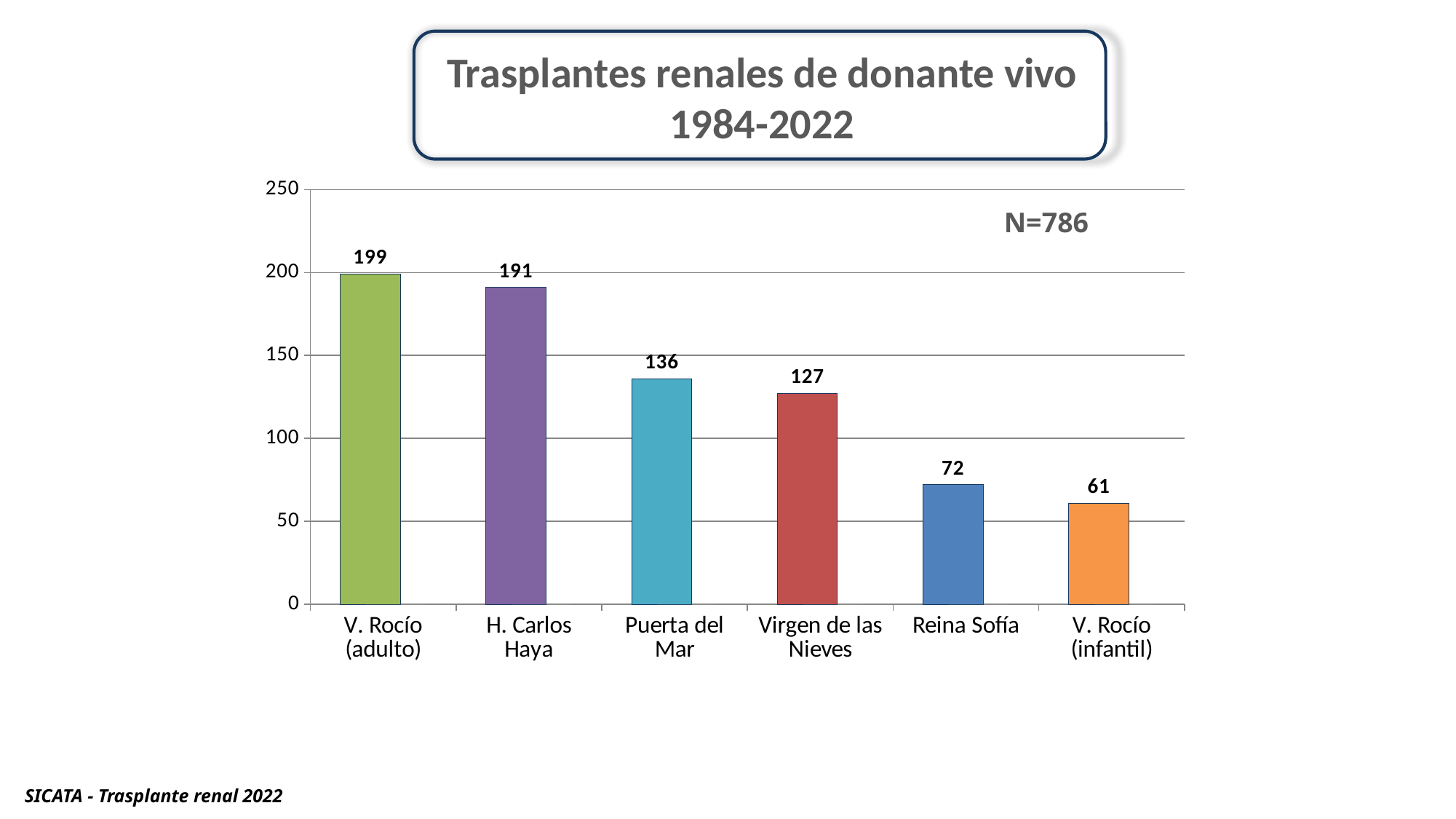
What kind of chart is shown on the slide? bar chart Is the value for Virgen de las Nieves greater or less than 150? less Do the values rise or fall from left to right along the x axis? fall Which is larger, the value for Puerta del Mar or the value for Reina Sofía? Puerta del Mar What is the value for V. Rocío (adulto)? 199 Which category has the highest value? V. Rocío (adulto) What is the value for Puerta del Mar? 136 How many categories are shown on the x axis? 6 What is the difference between the values for H. Carlos Haya and Virgen de las Nieves? 64 What is the title of the chart? Trasplantes renales de donante vivo 1984-2022 Which category has the lowest value? V. Rocío (infantil) What is the value for Reina Sofía? 72